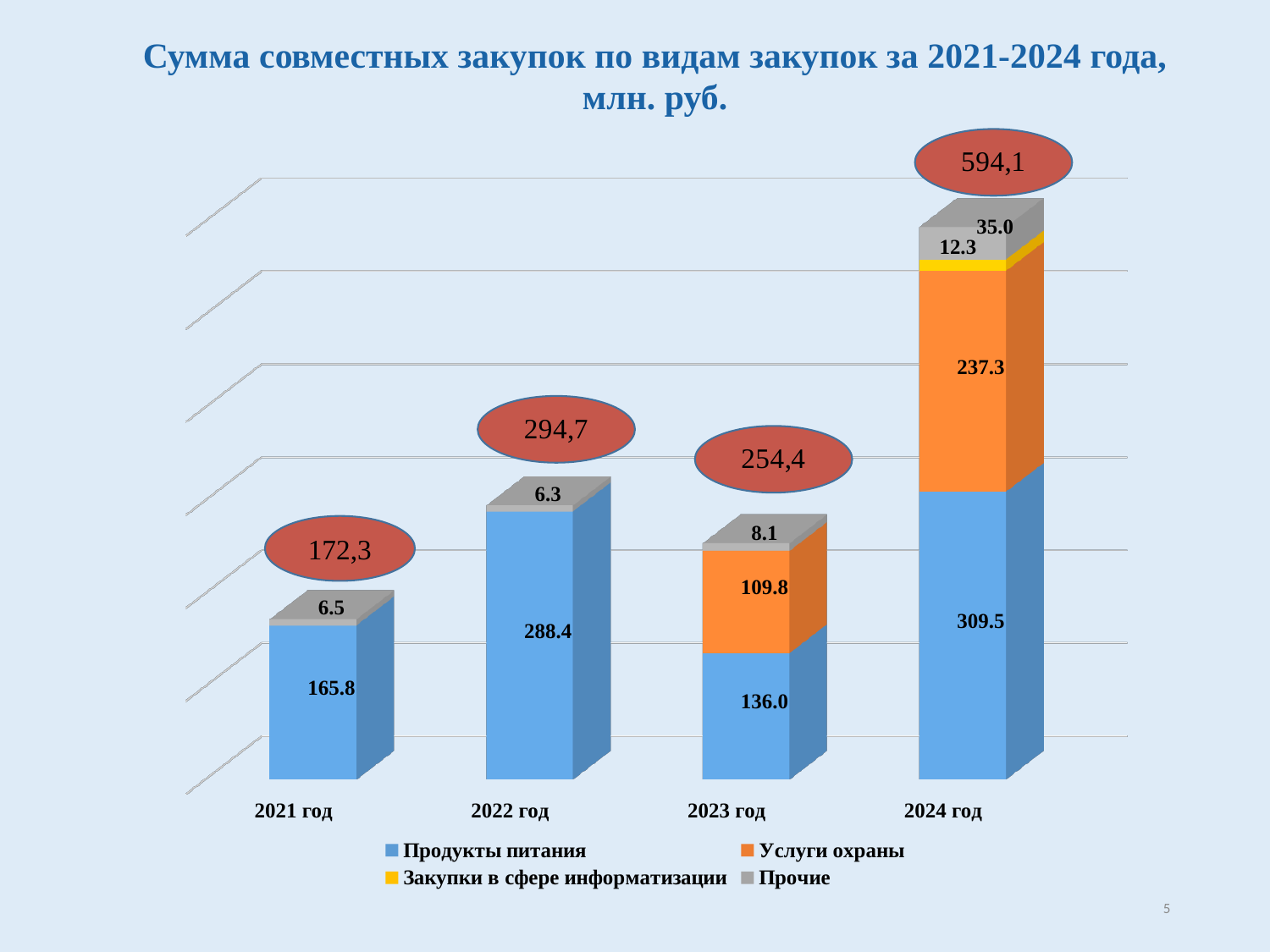
What is the value for Прочие in 2021 год? 6.5 What is the value for Закупки в сфере информатизации in 2024 год? 12.3 What is the difference between the Услуги охраны values for 2024 год and 2023 год? 127.5 Which is larger: Продукты питания in 2022 год or Продукты питания in 2021 год? 2022 год How many years are shown on the x axis? 4 What is the total shown for the 2024 год stacked bar? 594,1 What kind of chart is shown on the slide? Stacked bar chart How many series does the legend list? 4 What is the value for Продукты питания in 2024 год? 309.5 What is the value for Услуги охраны in 2023 год? 109.8 Which year has the lowest value for Продукты питания? 2023 год Which year has the highest value for Продукты питания? 2024 год